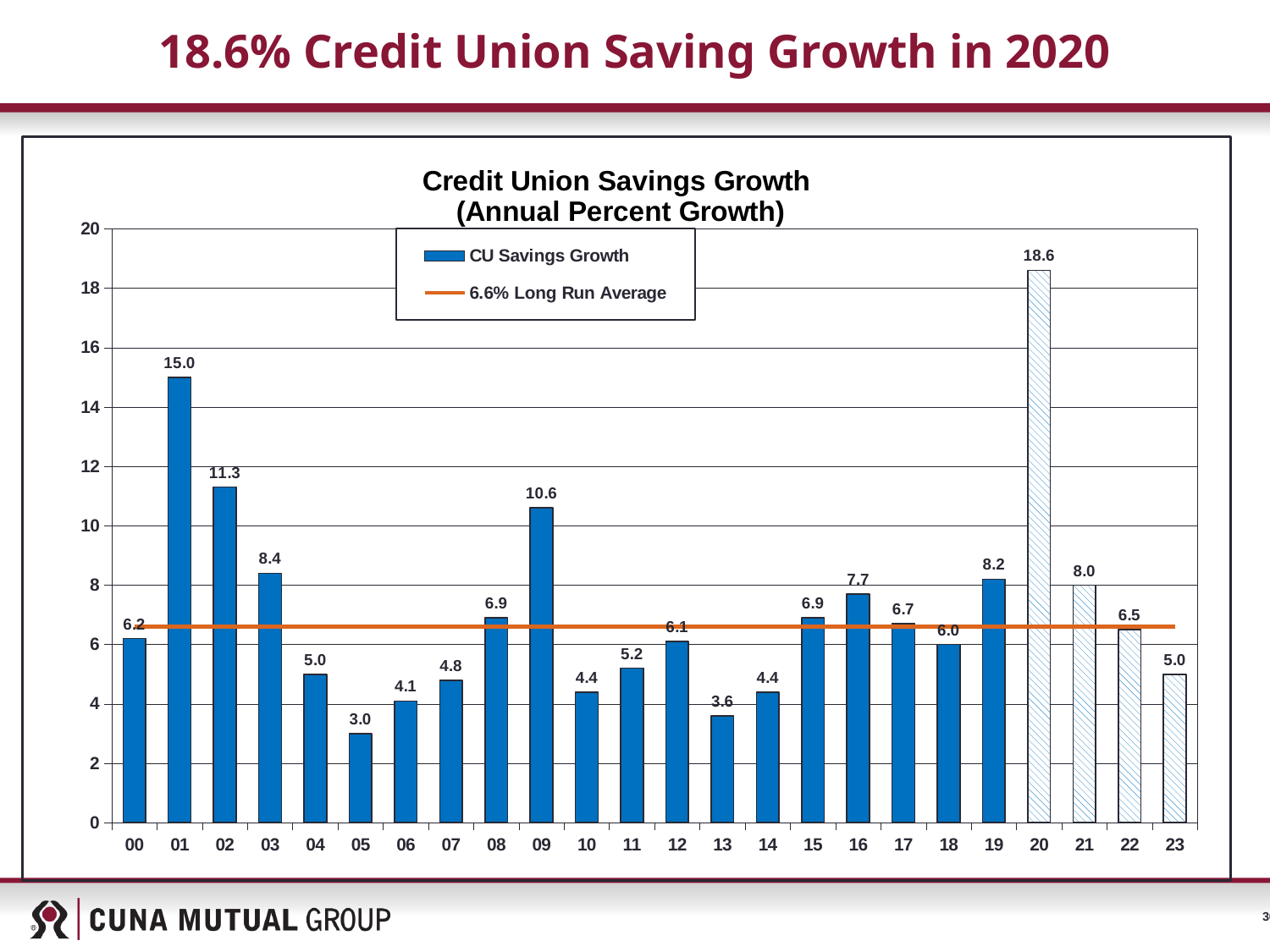
What is the difference between the CU Savings Growth values for 2001 and 2002? 3.7 What is the CU Savings Growth value for 2020? 18.6 How many years are shown on the x axis? 24 What is the title of the chart? Credit Union Savings Growth (Annual Percent Growth) What is the CU Savings Growth value for 2009? 10.6 What value does the horizontal line in the chart represent? 6.6% Long Run Average What kind of chart is shown? bar chart Which year has the lowest CU Savings Growth? 05 Which is larger, the CU Savings Growth value for 2016 or for 2017? 2016 Is the CU Savings Growth value for 2013 greater or less than 4? less Which year has the highest CU Savings Growth? 20 How many series does the legend list? 2